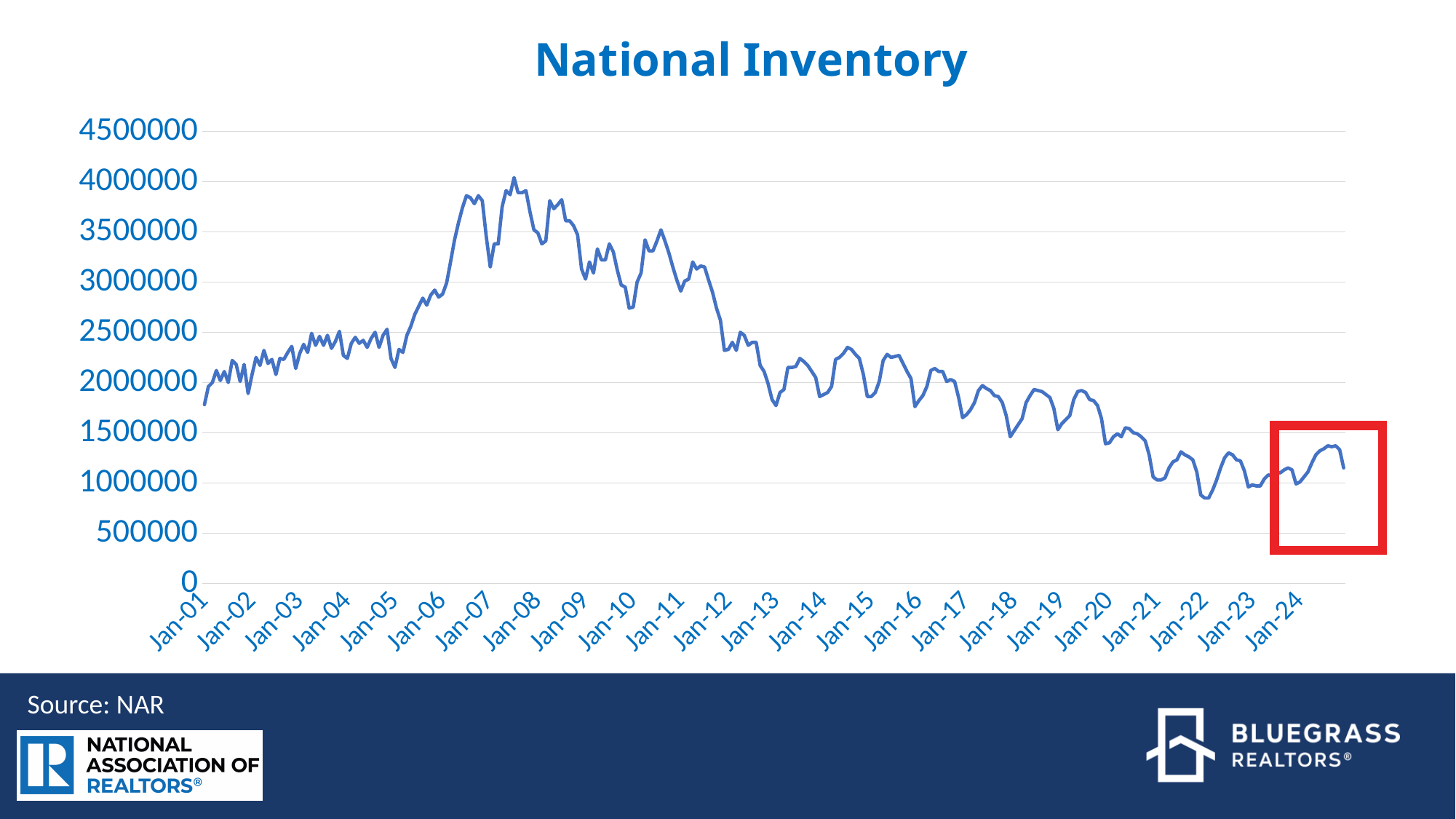
Is the value at Jan-01 greater or less than 2000000? less What kind of chart is shown on the slide? line chart Is the value at Jan-17 greater or less than 1500000? greater What is the source cited for the chart's data? NAR Is the lowest point on the line, near Jan-22, greater or less than 1000000? less Does the line generally rise or fall from Jan-08 to Jan-24? fall What is the title of the chart? National Inventory Which is larger, the value at Jan-08 or the value at Jan-20? Jan-08 How many year labels (Jan-01 through Jan-24) are shown on the x axis? 24